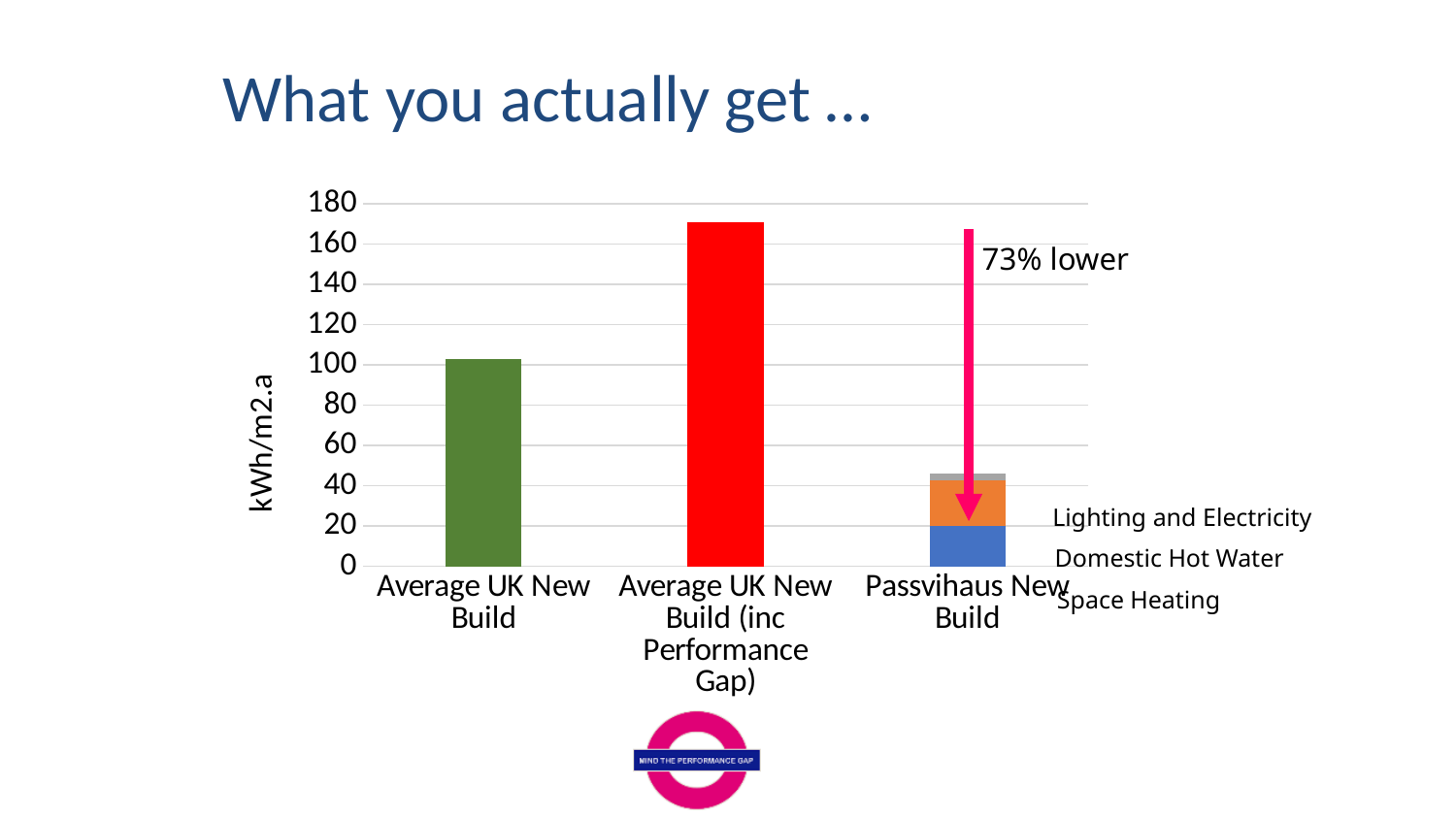
Which category has the lowest total value in the chart? Passvihaus New Build Is the total value for Passvihaus New Build greater or less than 60? less Is the value for Average UK New Build (inc Performance Gap) greater or less than 160? greater How many categories are shown on the x axis of the chart? 3 Which category has the highest total value in the chart? Average UK New Build (inc Performance Gap) What kind of chart is shown on the slide? bar chart How many series does the chart's legend list? 3 Which is larger: the value for Average UK New Build or the value for Passvihaus New Build? Average UK New Build Is the value for Average UK New Build greater or less than 120? less What is the label on the y axis of the chart? kWh/m2.a What does the annotation next to the arrow above the Passvihaus New Build bar say? 73% lower